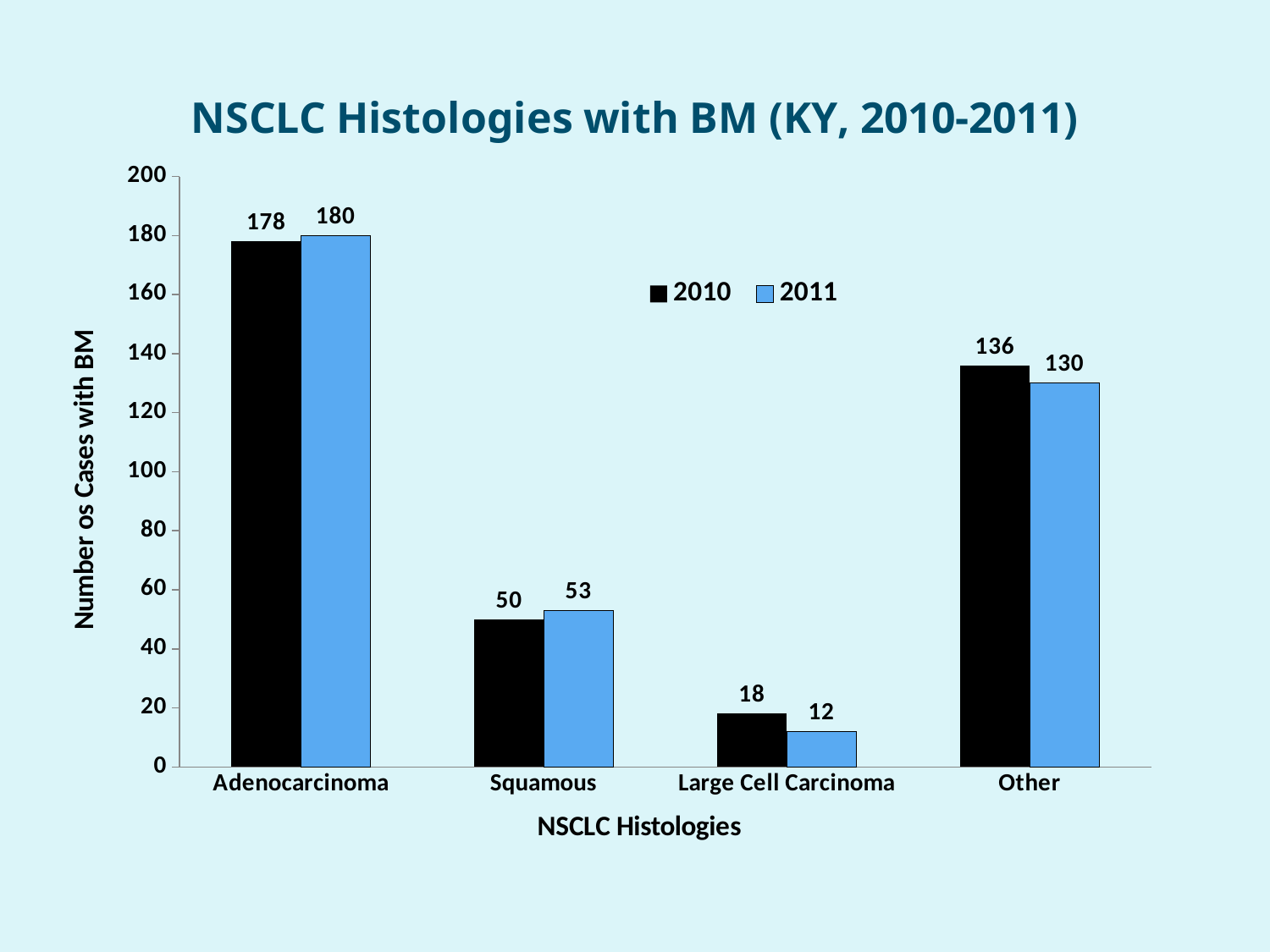
Which is larger for Large Cell Carcinoma: the 2010 value or the 2011 value? 2010 What is the difference between the Squamous values for 2011 and 2010? 3 What is the number of cases with BM for Adenocarcinoma in 2010? 178 What is the difference between the 2010 and 2011 values for Other? 6 What is the value for Other in 2010? 136 How many series does the legend list? 2 How many histology categories are shown on the x axis? 4 What is the number of cases with BM for Large Cell Carcinoma in 2011? 12 Which histology has the highest number of cases with BM in 2011? Adenocarcinoma Which histology has the lowest number of cases with BM in 2010? Large Cell Carcinoma What is the title of the chart? NSCLC Histologies with BM (KY, 2010-2011) What kind of chart is shown on the slide? Bar chart